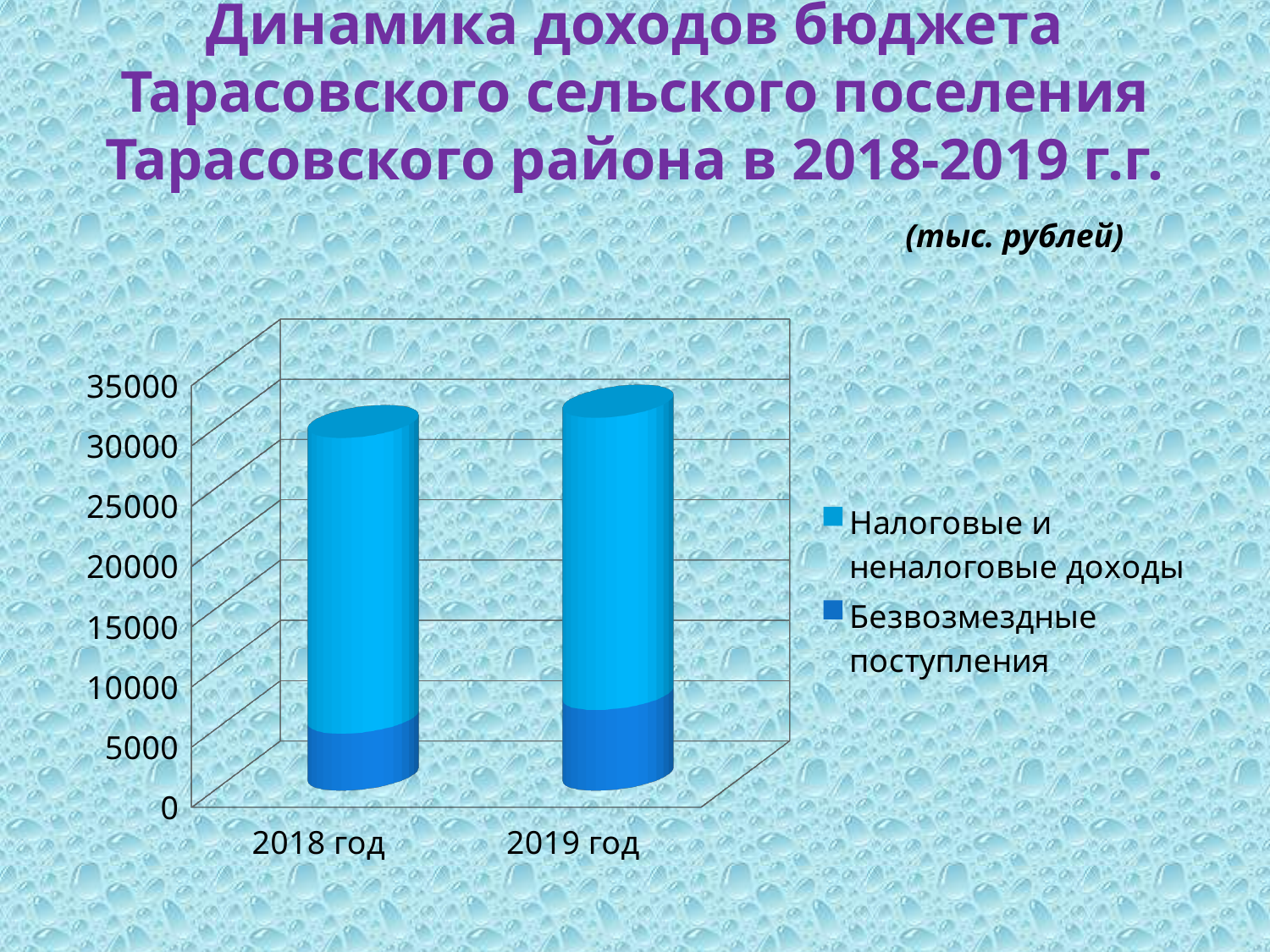
Do total budget revenues rise or fall from 2018 год to 2019 год? Rise Is the value of Безвозмездные поступления for 2019 год greater or less than 10000? less Which year has the taller total bar, 2018 год or 2019 год? 2019 год Which series is shown in the darker blue colour in the chart legend? Безвозмездные поступления How many series does the chart legend list? 2 Is the total value of the bar for 2019 год greater or less than 30000? greater What kind of chart is shown on the slide? Stacked bar chart How many years (categories) are shown on the x axis of the chart? 2 Is the total value of the bar for 2018 год greater or less than 25000? greater Which year has the larger value for Безвозмездные поступления, 2018 год or 2019 год? 2019 год In what units are the values on the chart expressed, according to the slide? тыс. рублей